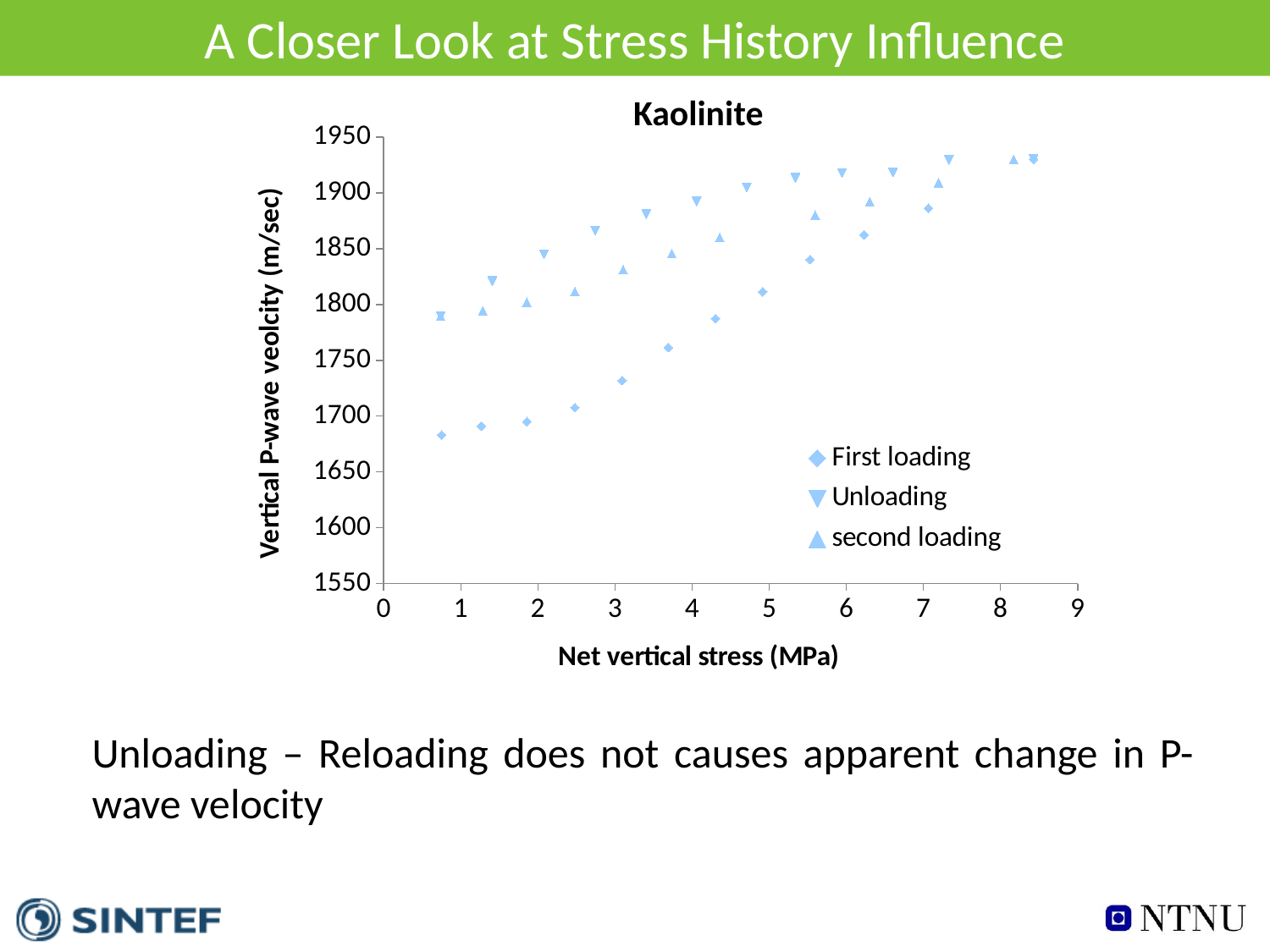
How many series does the legend list? 3 What is the title of the chart? Kaolinite At a net vertical stress of about 3 MPa, which series has the lower P-wave velocity, First loading or second loading? First loading Is the Unloading value at the lowest net vertical stress greater or less than 1750? greater What kind of chart is shown on the slide? scatter chart Is the Unloading value at the highest net vertical stress greater or less than 1900? greater Do the second loading values rise or fall as net vertical stress increases? rise What is the label of the x axis? Net vertical stress (MPa) At a net vertical stress of about 1 MPa, which series has the higher P-wave velocity, First loading or Unloading? Unloading Is the First loading value at the lowest net vertical stress greater or less than 1700? less Do the First loading values rise or fall as net vertical stress increases? rise